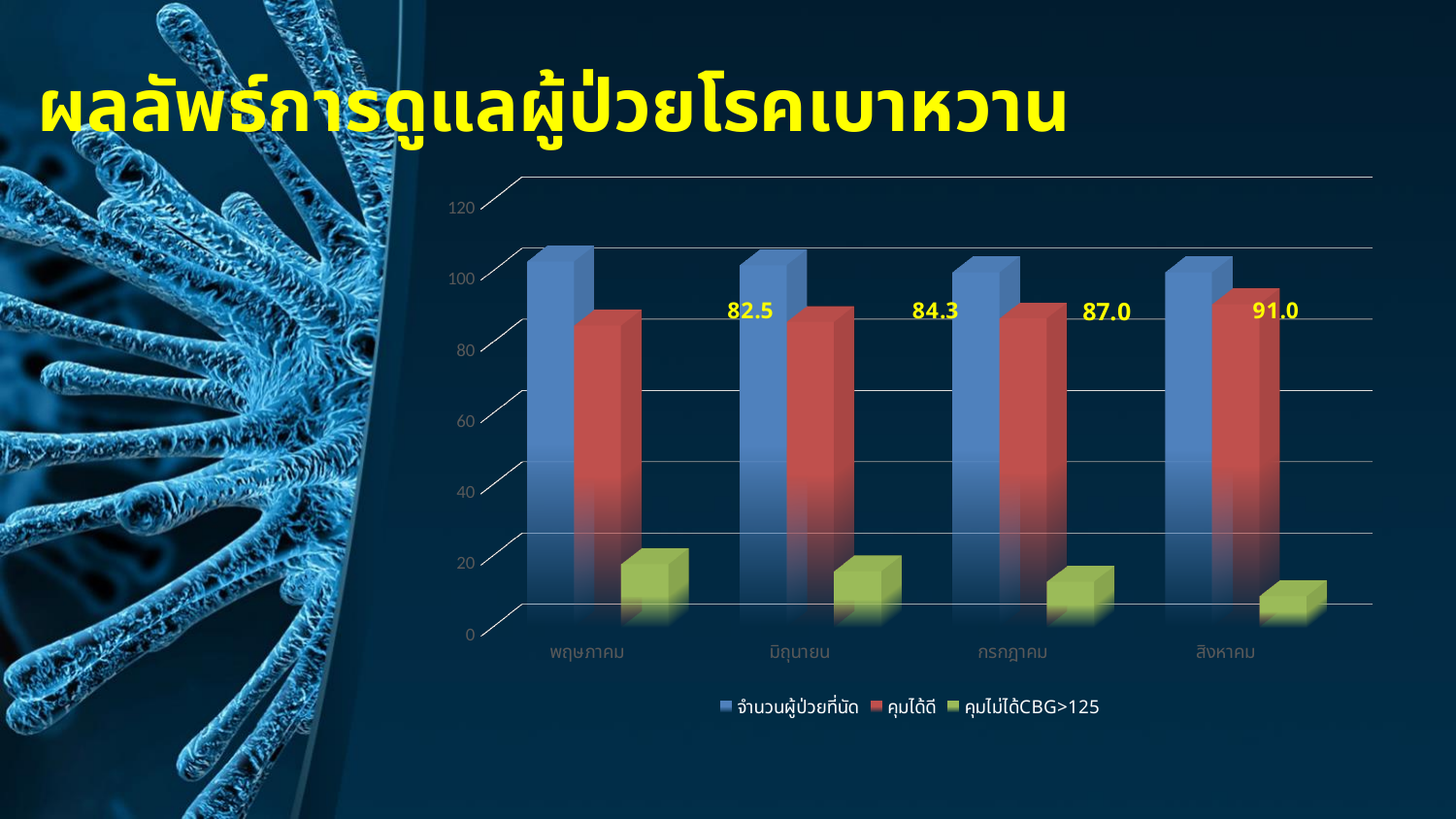
Is the value of จำนวนผู้ป่วยที่นัด for พฤษภาคม greater or less than 80? greater What is the difference between the data labels 91.0 and 82.5 shown on the chart? 8.5 How many months (categories) are shown on the x axis of the chart? 4 What type of chart is shown on the slide? bar chart How many series does the chart legend list? 3 Do the คุมได้ดี (red) bars rise or fall from พฤษภาคม to สิงหาคม? rise Which series is shown in green in the chart legend? คุมไม่ได้CBG>125 Is the value of คุมไม่ได้CBG>125 for สิงหาคม greater or less than 40? less What is the title of the slide above the chart? ผลลัพธ์การดูแลผู้ป่วยโรคเบาหวาน What is the highest data label value printed on the chart? 91.0 What is the lowest data label value printed on the chart? 82.5 What is the data label printed next to the สิงหาคม bars? 91.0